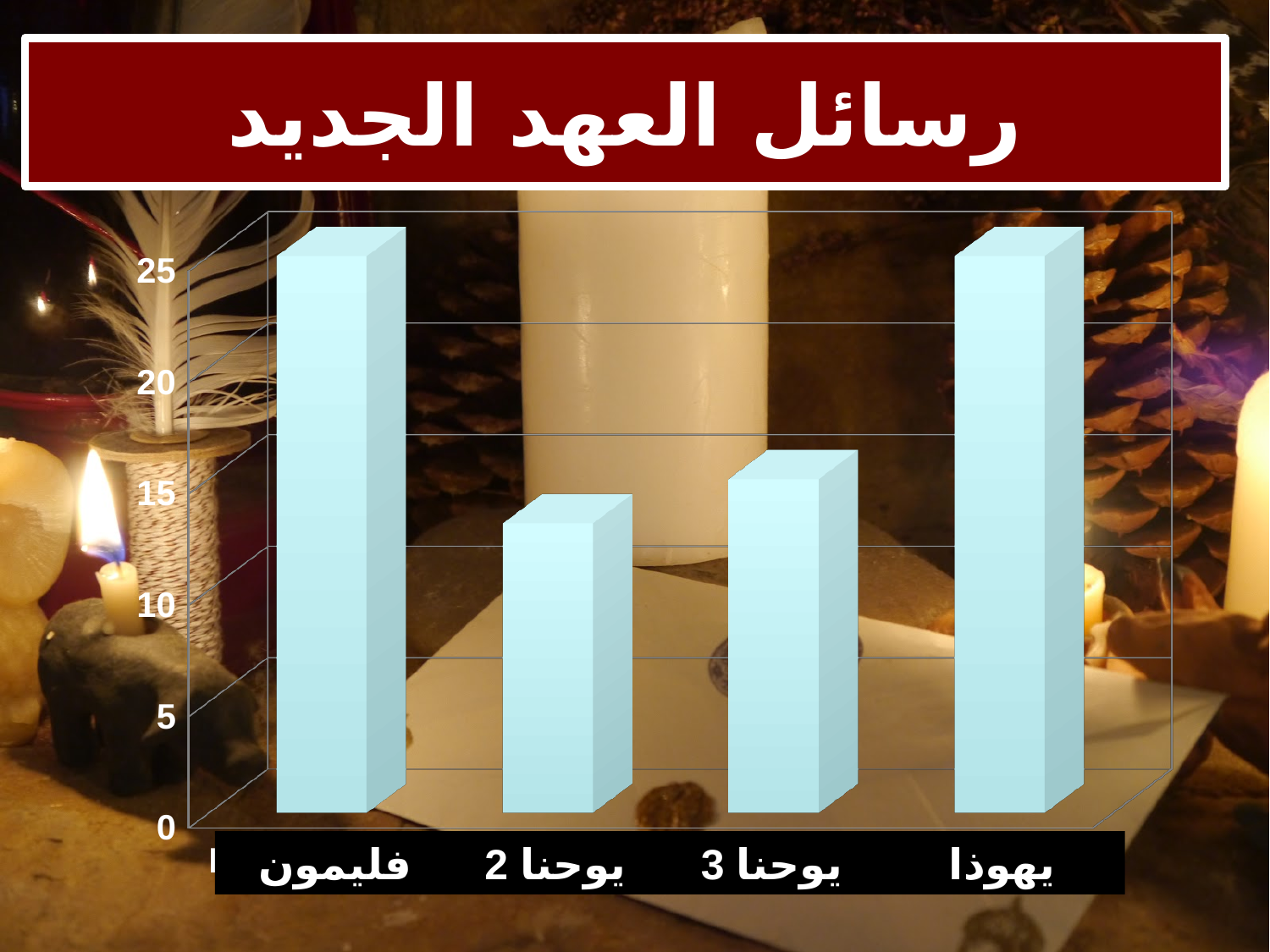
Is the value for يوحنا 2 greater or less than 10? greater Is the value for يوحنا 3 greater or less than 20? less What is the highest value shown on the vertical axis? 25 What kind of chart is shown on the slide? bar chart Which is larger, the value for فليمون or the value for يوحنا 3? فليمون Is the value for يهوذا greater or less than 20? greater How many categories are plotted in the chart? 4 What is the title of the slide? رسائل العهد الجديد Which category has the lowest bar? يوحنا 2 Which is larger, the value for يوحنا 3 or the value for يوحنا 2? يوحنا 3